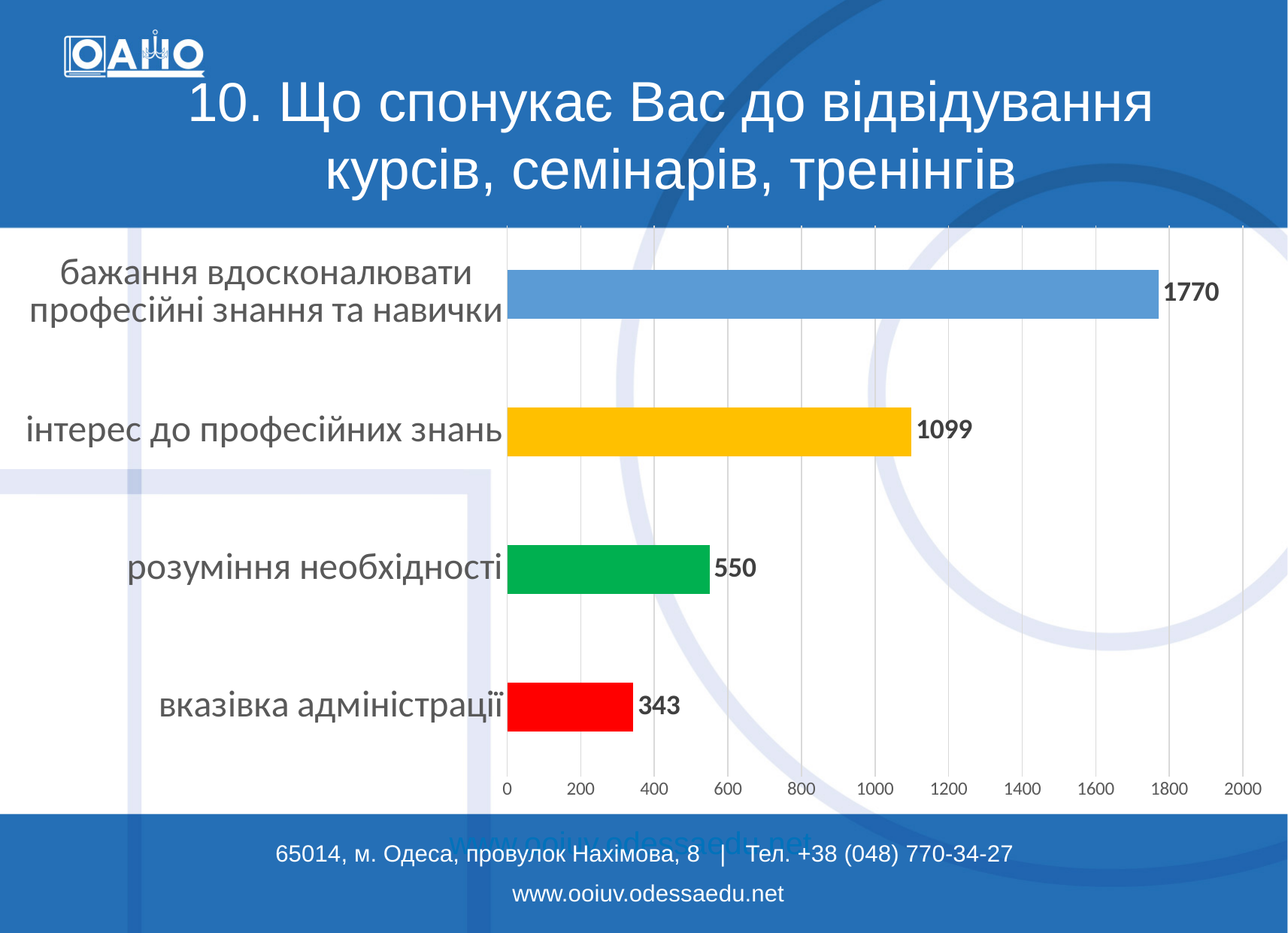
Which category has the highest value? бажання вдосконалювати професійні знання та навички What is the value for "розуміння необхідності"? 550 What kind of chart is shown on the slide? bar chart What is the value for "бажання вдосконалювати професійні знання та навички"? 1770 What is the difference between the values for "розуміння необхідності" and "вказівка адміністрації"? 207 How many categories are shown in the chart? 4 What is the difference between the values for "бажання вдосконалювати професійні знання та навички" and "інтерес до професійних знань"? 671 Which is larger: the value for "інтерес до професійних знань" or the value for "розуміння необхідності"? інтерес до професійних знань What is the value for "вказівка адміністрації"? 343 What is the value for "інтерес до професійних знань"? 1099 Which category has the lowest value? вказівка адміністрації Is the value for "вказівка адміністрації" greater or less than 400? less